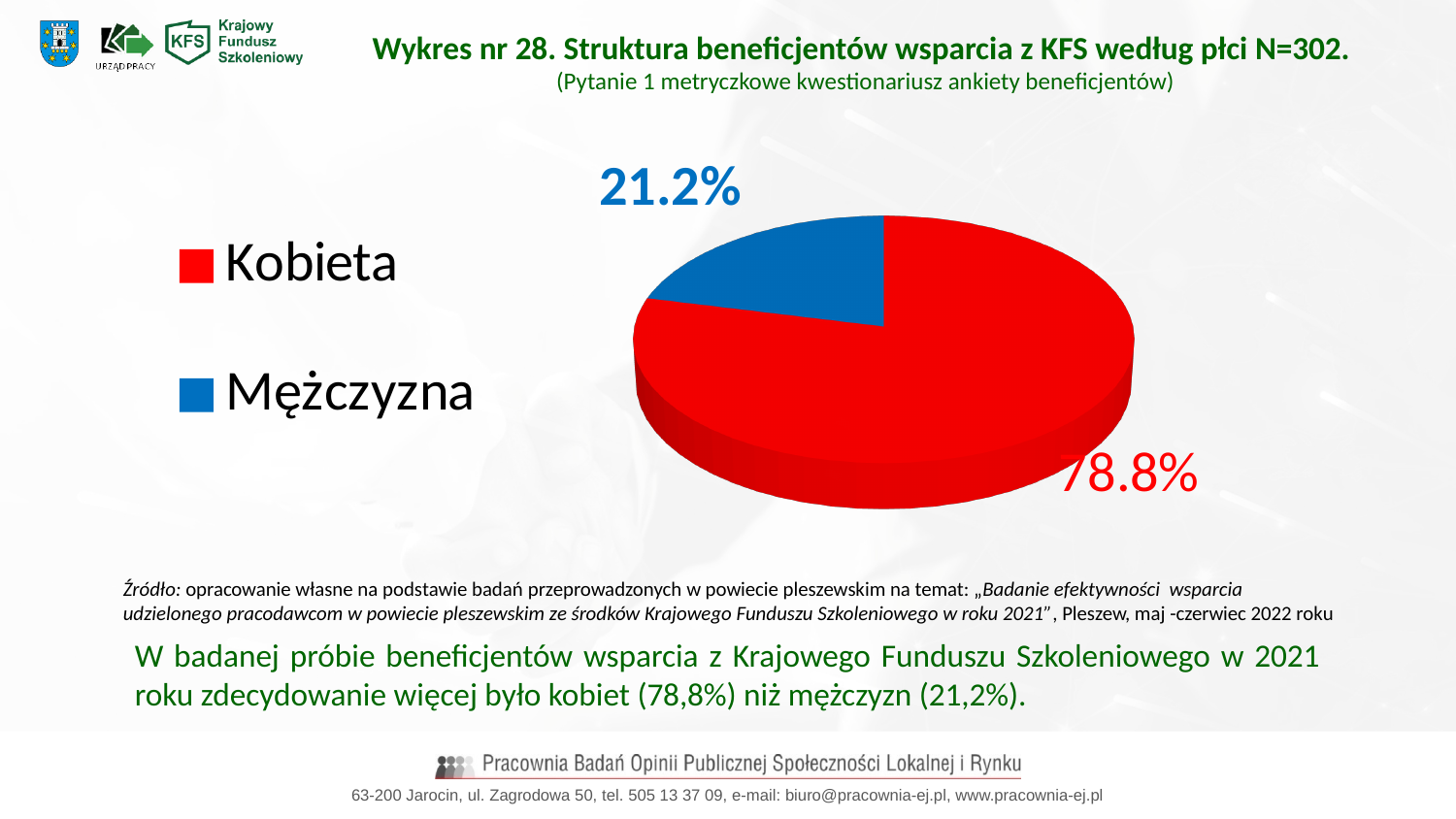
Which category has the smallest share of the pie? Mężczyzna Which slice is larger, Kobieta or Mężczyzna? Kobieta What percentage of the pie is labelled for Kobieta? 78.8% What is the difference in percentage points between the Kobieta and Mężczyzna slices? 57.6 Which category has the largest share of the pie? Kobieta What is the sample size N given in the chart title? 302 How many entries does the legend list? 2 What kind of chart is shown on the slide? pie chart What colour is the Kobieta slice? red How many categories does the pie chart show? 2 What percentage of the pie is labelled for Mężczyzna? 21.2%